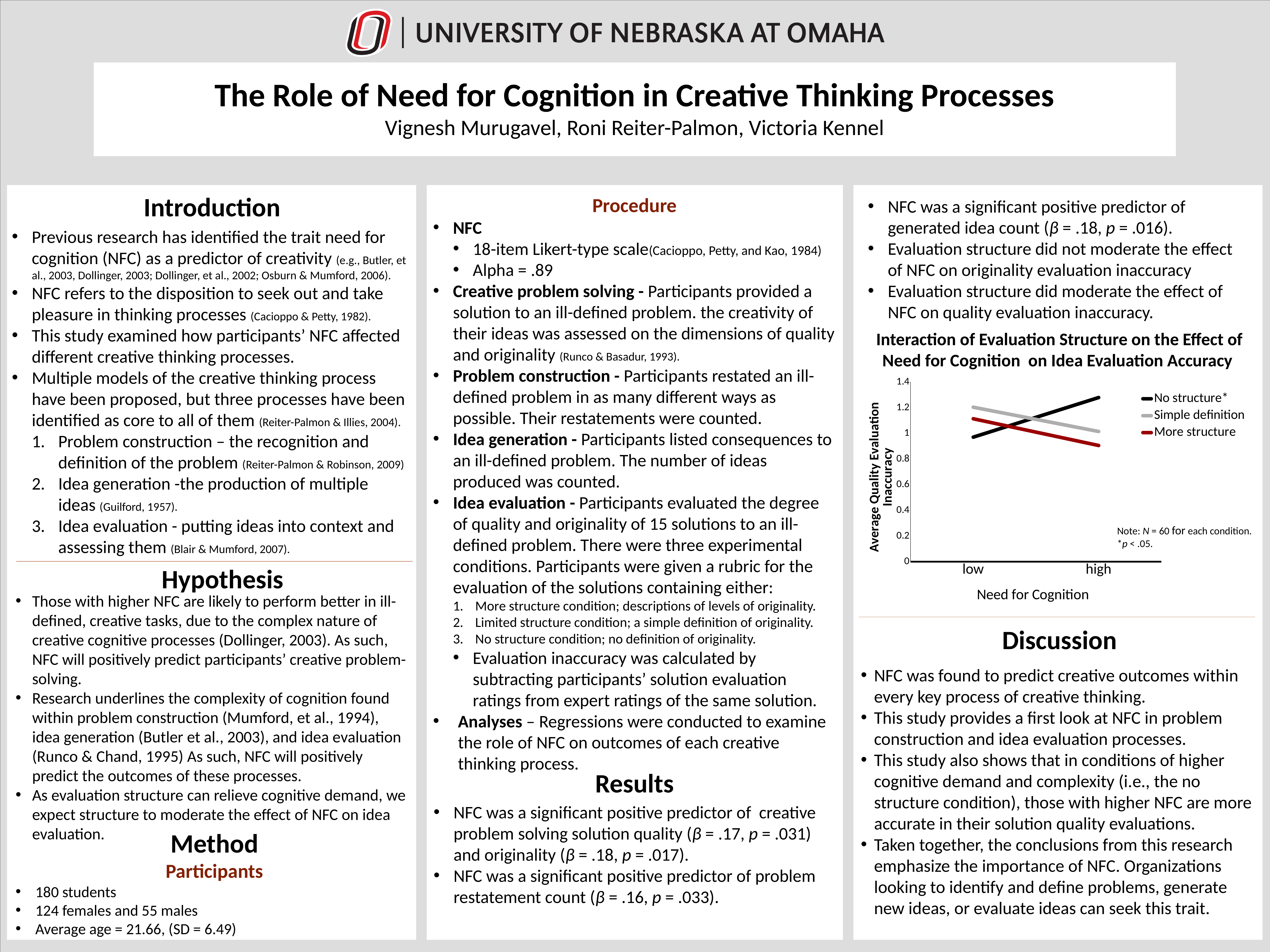
Does the "Simple definition" line rise or fall from low to high Need for Cognition? fall Is the value for "No structure*" at high Need for Cognition greater or less than 1.2? greater Is the value for "More structure" at high Need for Cognition greater or less than 1? less Which series has the highest value at high Need for Cognition? No structure* Does the "More structure" line rise or fall from low to high Need for Cognition? fall How many series does the legend of the chart list? 3 What is the label of the y axis of the chart? Average Quality Evaluation Inaccuracy At low Need for Cognition, which is larger: "Simple definition" or "No structure*"? Simple definition How many categories are shown on the x axis of the chart? 2 What kind of chart is shown under the title "Interaction of Evaluation Structure on the Effect of Need for Cognition on Idea Evaluation Accuracy"? line chart Does the "No structure*" line rise or fall from low to high Need for Cognition? rise What is the label of the x axis of the chart? Need for Cognition